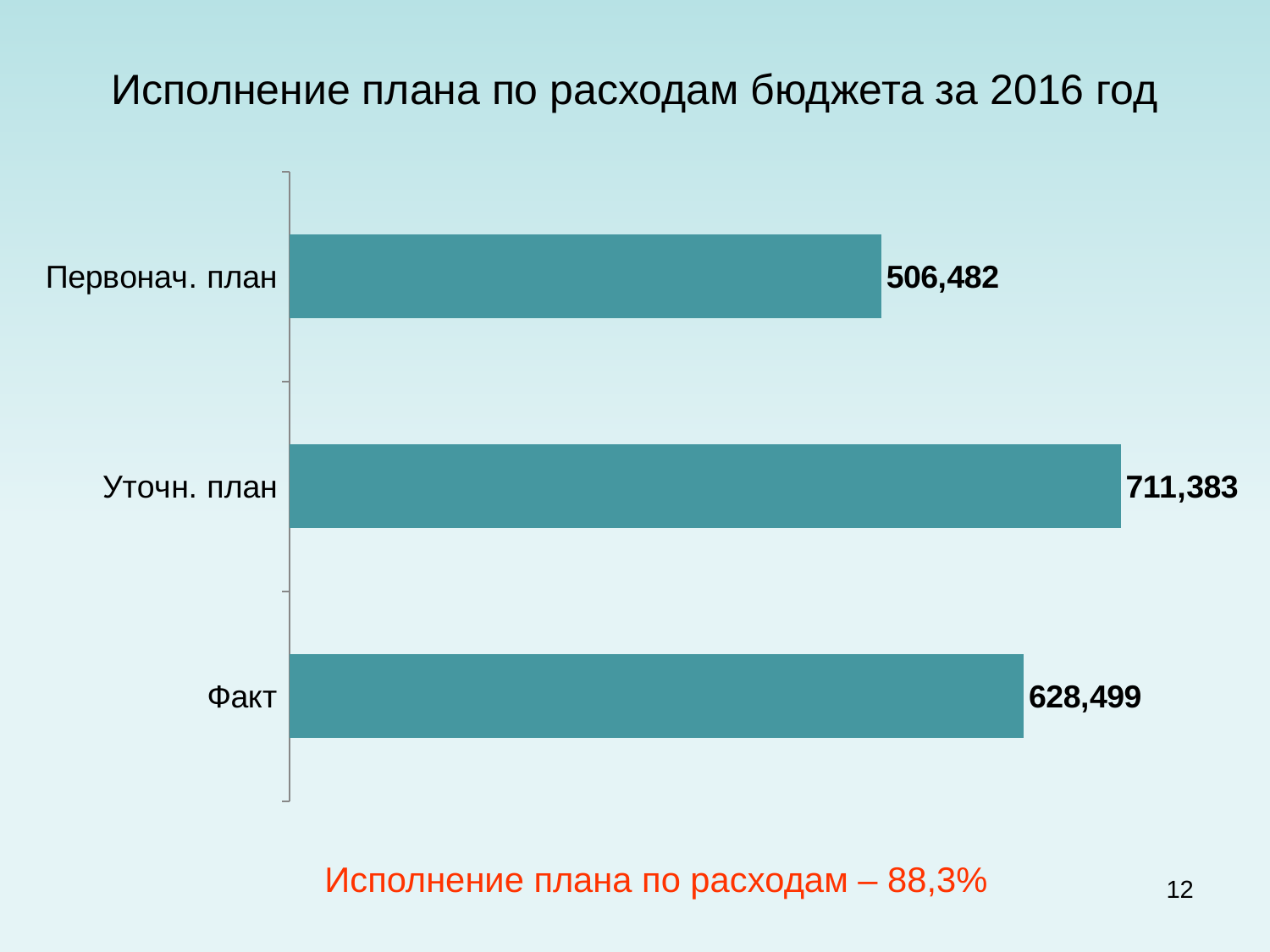
What kind of chart is shown on the slide? Bar chart Which category has the highest value? Уточн. план What is the title of the slide? Исполнение плана по расходам бюджета за 2016 год Which category has the lowest value? Первонач. план What is the difference between Факт and Первонач. план? 122,017 What is the value for Уточн. план? 711,383 How many categories are shown in the chart? 3 What is the value for Факт? 628,499 Which is larger, Факт or Первонач. план? Факт What is the difference between Уточн. план and Факт? 82,884 What is the difference between Уточн. план and Первонач. план? 204,901 What is the value for Первонач. план? 506,482